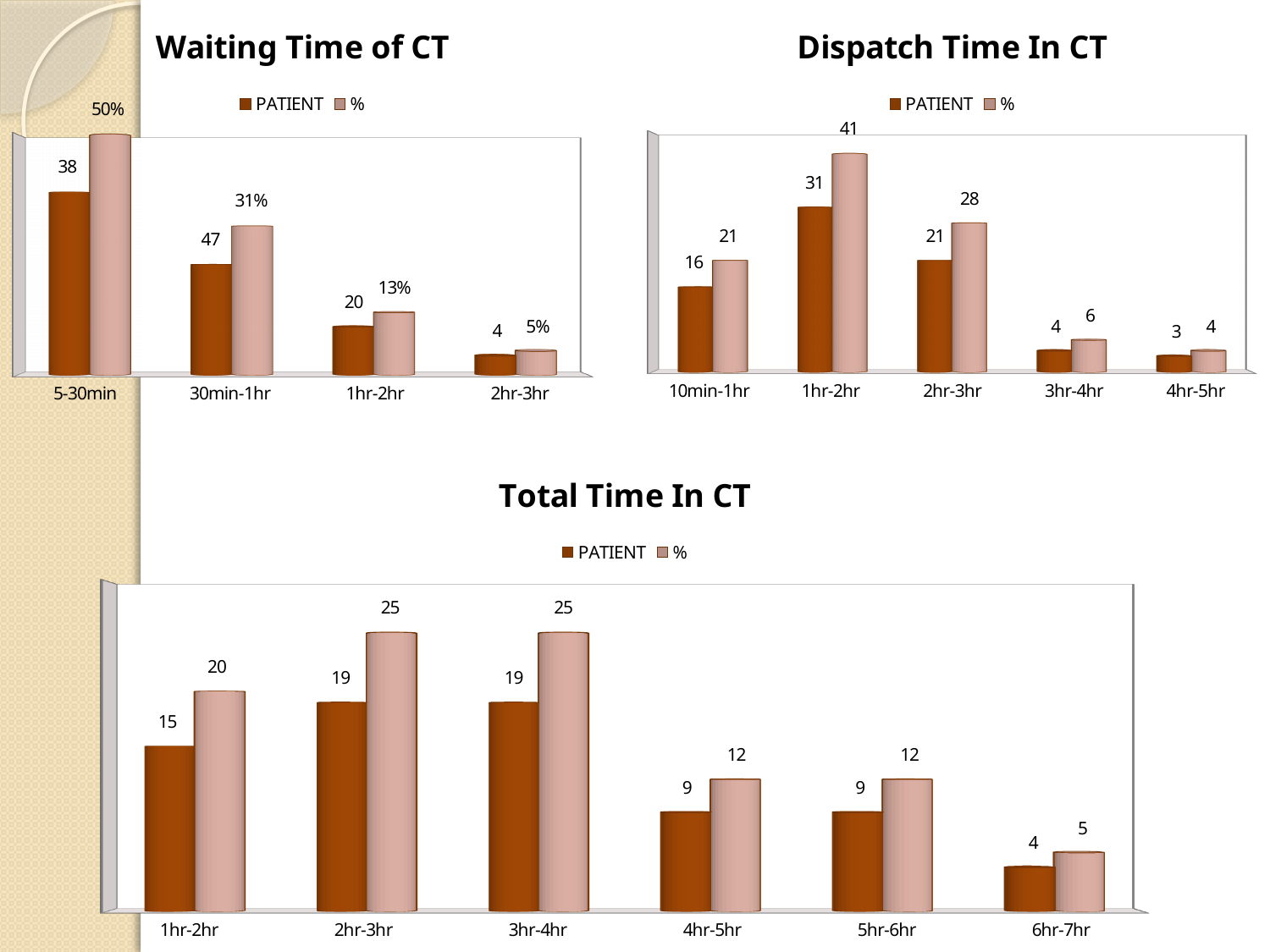
In the Dispatch Time In CT chart, which category has the highest PATIENT value? 1hr-2hr How many series does the legend of the Total Time In CT chart list? 2 In the Dispatch Time In CT chart, what is the % value for 2hr-3hr? 28 In the Dispatch Time In CT chart, what is the difference between the PATIENT values for 1hr-2hr and 2hr-3hr? 10 In the Total Time In CT chart, which category has the lowest % value? 6hr-7hr In the Dispatch Time In CT chart, which category has the lowest PATIENT value? 4hr-5hr In the Total Time In CT chart, what is the PATIENT value for 1hr-2hr? 15 In the Waiting Time of CT chart, how many categories are shown on the x axis? 4 In the Waiting Time of CT chart, what is the % value for 5-30min? 50% In the Waiting Time of CT chart, what is the PATIENT value for 30min-1hr? 47 In the Total Time In CT chart, how many categories are shown on the x axis? 6 In the Total Time In CT chart, is the PATIENT value for 2hr-3hr larger or smaller than the PATIENT value for 4hr-5hr? larger